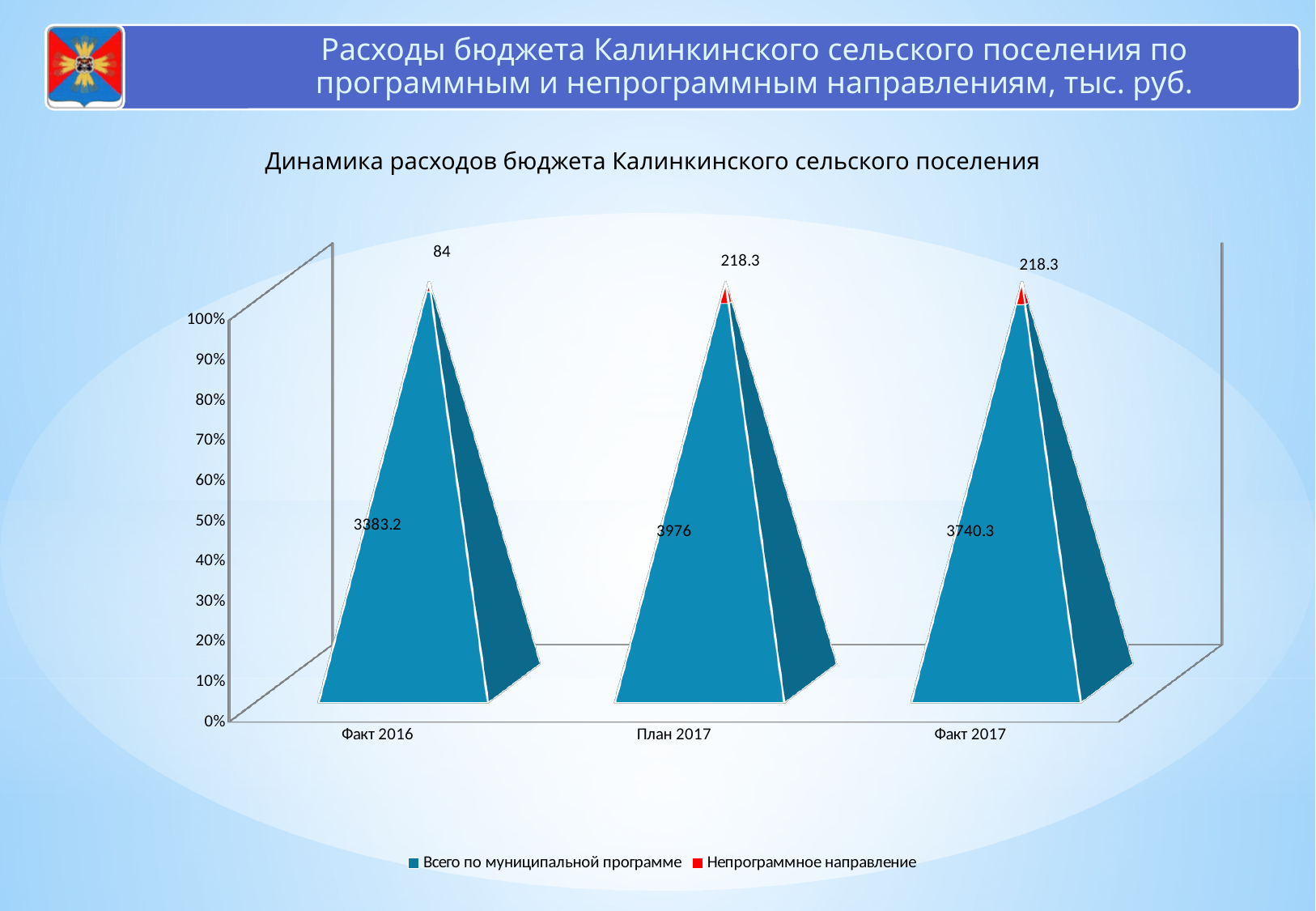
Which is larger: the "Всего по муниципальной программе" value for Факт 2016 or for Факт 2017? Факт 2017 What is the value for "Всего по муниципальной программе" in Факт 2017? 3740.3 What is the value for "Всего по муниципальной программе" in Факт 2016? 3383.2 What is the value for "Непрограммное направление" in Факт 2016? 84 What is the difference between the "Всего по муниципальной программе" values for План 2017 and Факт 2017? 235.7 Which category has the lowest value for "Непрограммное направление"? Факт 2016 What is the total of the two values for План 2017? 4194.3 How many categories are shown on the x axis? 3 What is the value for "Непрограммное направление" in План 2017? 218.3 What is the title of the chart? Динамика расходов бюджета Калинкинского сельского поселения How many series does the legend list? 2 Which category has the highest value for "Всего по муниципальной программе"? План 2017